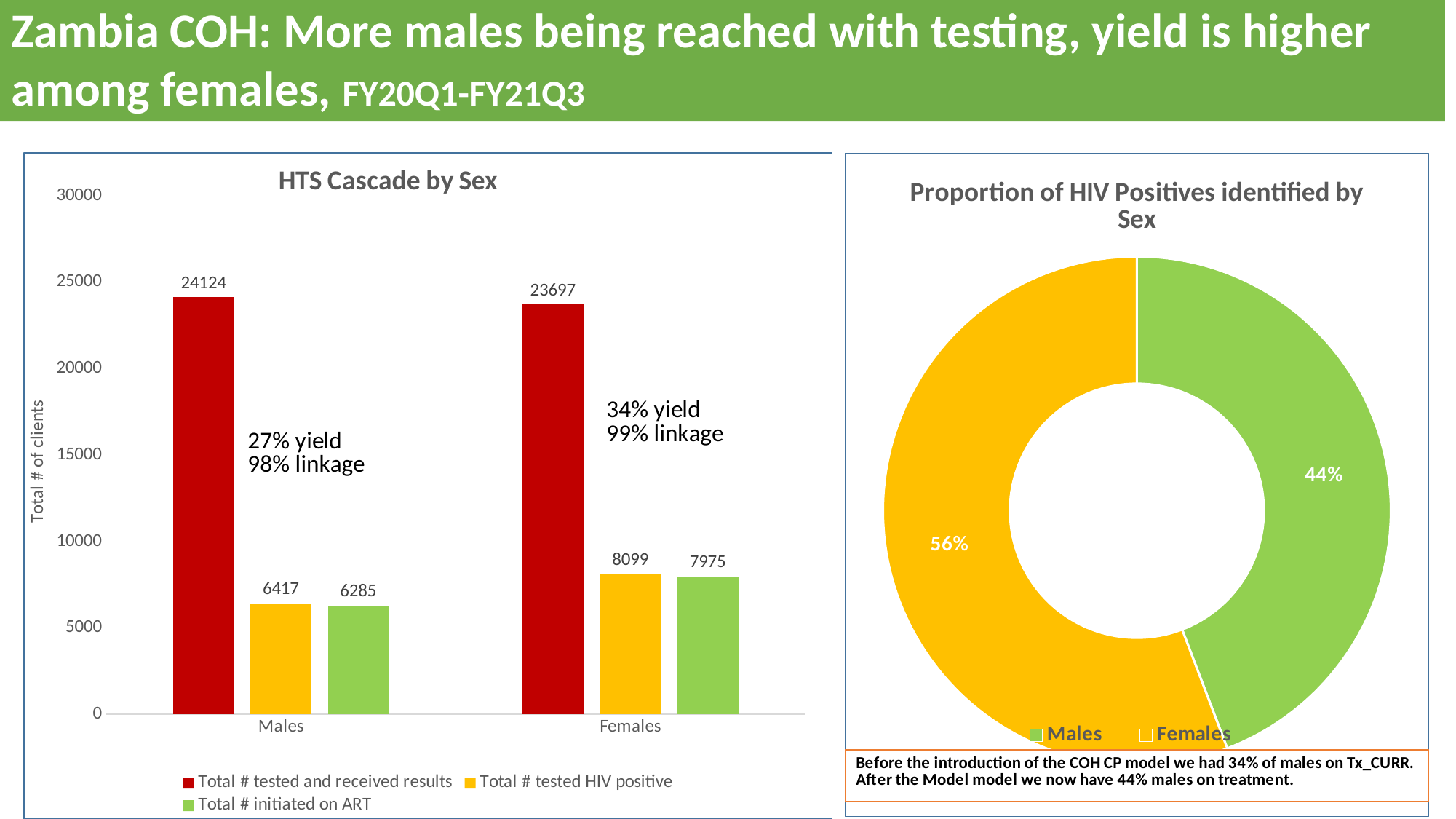
In the 'Proportion of HIV Positives identified by Sex' chart, which category has the larger share? Females In the 'Proportion of HIV Positives identified by Sex' chart, what share is Males? 44% In the 'Proportion of HIV Positives identified by Sex' chart, what share is Females? 56% In the 'HTS Cascade by Sex' chart, what is the total number initiated on ART for Males? 6285 How many series does the legend of the 'HTS Cascade by Sex' chart list? 3 What type of chart is 'HTS Cascade by Sex'? Bar chart In the 'HTS Cascade by Sex' chart, what is the difference between the number tested and received results for Males and for Females? 427 In the 'HTS Cascade by Sex' chart, what is the total number tested HIV positive for Females? 8099 In the 'HTS Cascade by Sex' chart, what is the y-axis title? Total # of clients In the 'HTS Cascade by Sex' chart, what is the total number tested and received results for Males? 24124 In the 'HTS Cascade by Sex' chart, what is the difference between the number tested HIV positive and the number initiated on ART for Females? 124 In the 'HTS Cascade by Sex' chart, which sex has the higher number tested HIV positive? Females